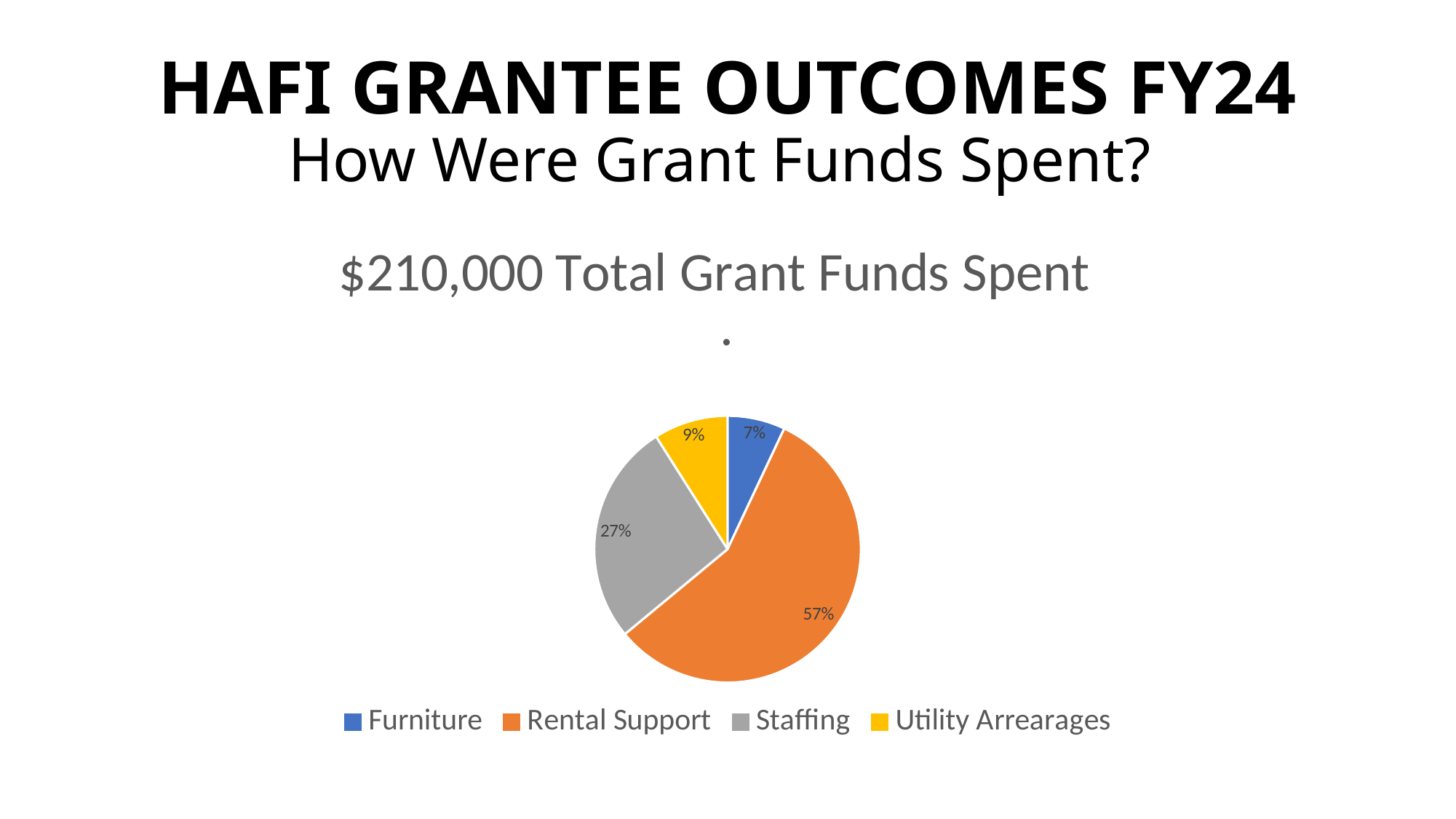
What total amount of grant funds spent is stated on the slide? $210,000 What share of grant funds was spent on Rental Support? 57% What is the difference in percentage points between the Rental Support and Staffing shares? 30 Which category received the smallest share of grant funds? Furniture How many categories does the pie chart show? 4 What share of grant funds was spent on Utility Arrearages? 9% Which category received the largest share of grant funds? Rental Support What share of grant funds was spent on Furniture? 7% What kind of chart is shown on the slide? Pie chart Which is larger, the share for Staffing or the share for Utility Arrearages? Staffing What colour is the Staffing slice in the pie chart? Grey